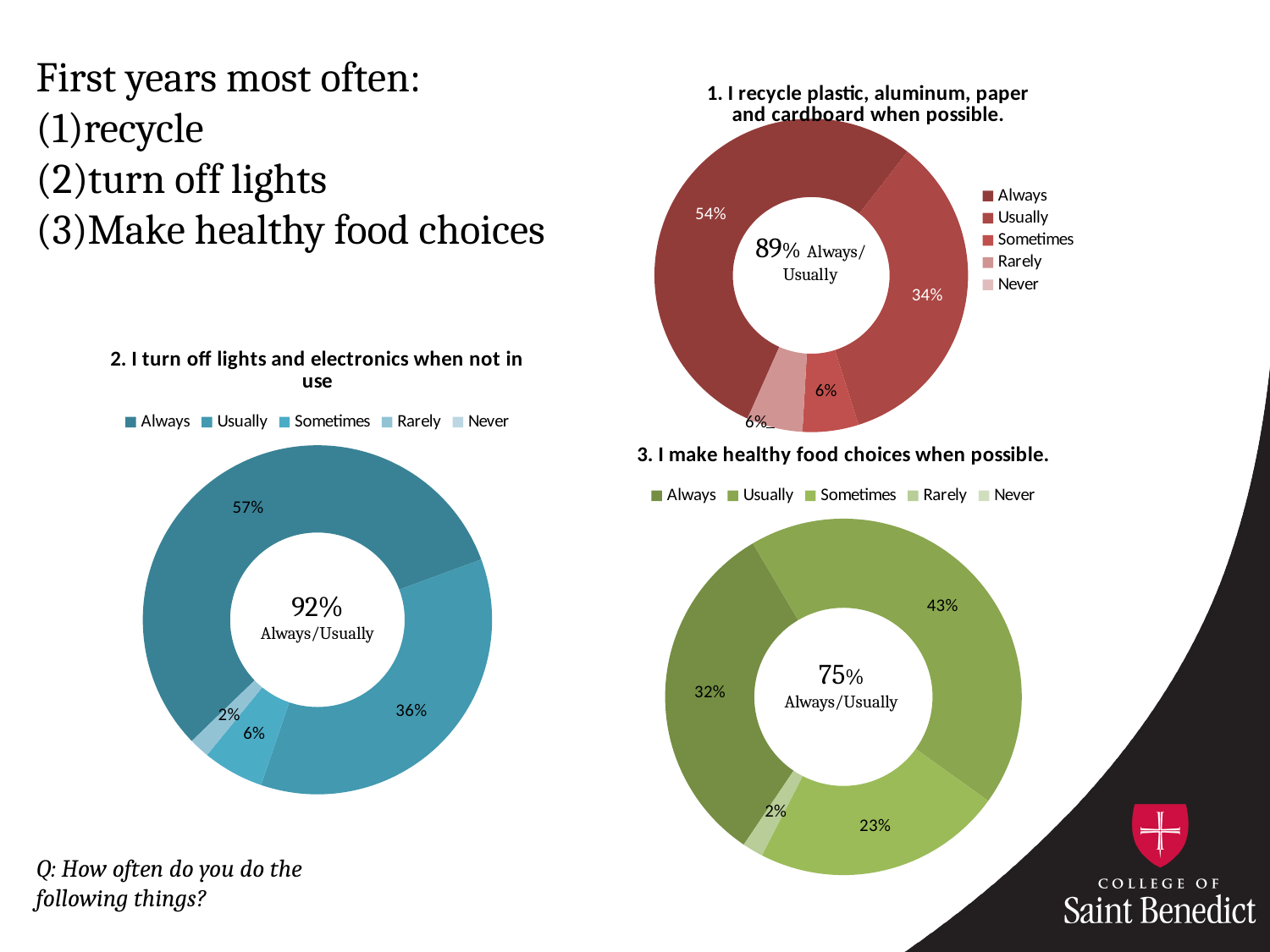
In the chart titled "3. I make healthy food choices when possible.", which response category has the largest share? Usually In the chart titled "3. I make healthy food choices when possible.", what percentage answered Sometimes? 23% In the chart titled "1. I recycle plastic, aluminum, paper and cardboard when possible.", what percentage answered Usually? 34% In the chart titled "2. I turn off lights and electronics when not in use", what percentage answered Rarely? 2% In the chart titled "1. I recycle plastic, aluminum, paper and cardboard when possible.", which is larger, the Always share or the Usually share? Always In the chart titled "1. I recycle plastic, aluminum, paper and cardboard when possible.", what percentage of respondents answered Always? 54% What kind of chart is used for "3. I make healthy food choices when possible."? Doughnut (pie) chart How many response categories does the legend list for the chart titled "2. I turn off lights and electronics when not in use"? 5 In the chart titled "2. I turn off lights and electronics when not in use", which response category has the largest share? Always In the chart titled "2. I turn off lights and electronics when not in use", what is the difference between the Always and Usually shares? 21% In the chart titled "3. I make healthy food choices when possible.", how many percentage points larger is Usually than Always? 11% In the chart titled "2. I turn off lights and electronics when not in use", what percentage answered Always? 57%